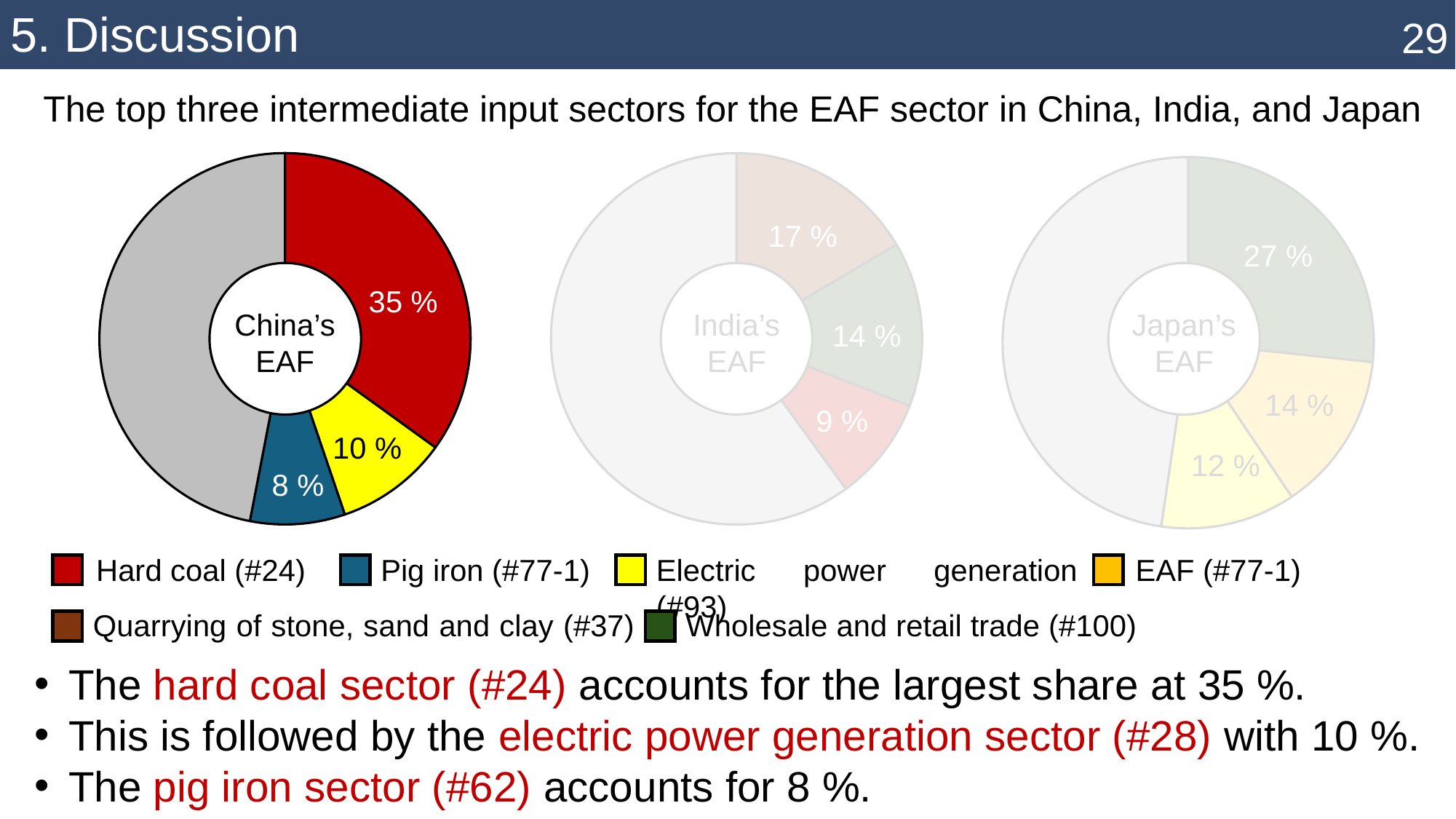
In the China's EAF chart, what share is shown for Pig iron (#77-1)? 8 % What kind of chart is used to show China's EAF input sectors? Pie (donut) chart In the China's EAF chart, which is larger: the share for Electric power generation (#93) or the share for Pig iron (#77-1)? Electric power generation (#93) In the China's EAF chart, which labelled sector has the largest share? Hard coal (#24) What is the largest percentage labelled in the India's EAF chart? 17 % In the China's EAF chart, what is the difference in percentage points between the Hard coal share and the Electric power generation share? 25 How many sectors are listed in the legend below the charts? 6 In the China's EAF chart, which labelled sector has the smallest share? Pig iron (#77-1) What is the largest percentage labelled in the Japan's EAF chart? 27 % In the China's EAF chart, what share is shown for Electric power generation (#93)? 10 % In the China's EAF chart, what share is shown for Hard coal (#24)? 35 % What is the smallest percentage labelled in the India's EAF chart? 9 %